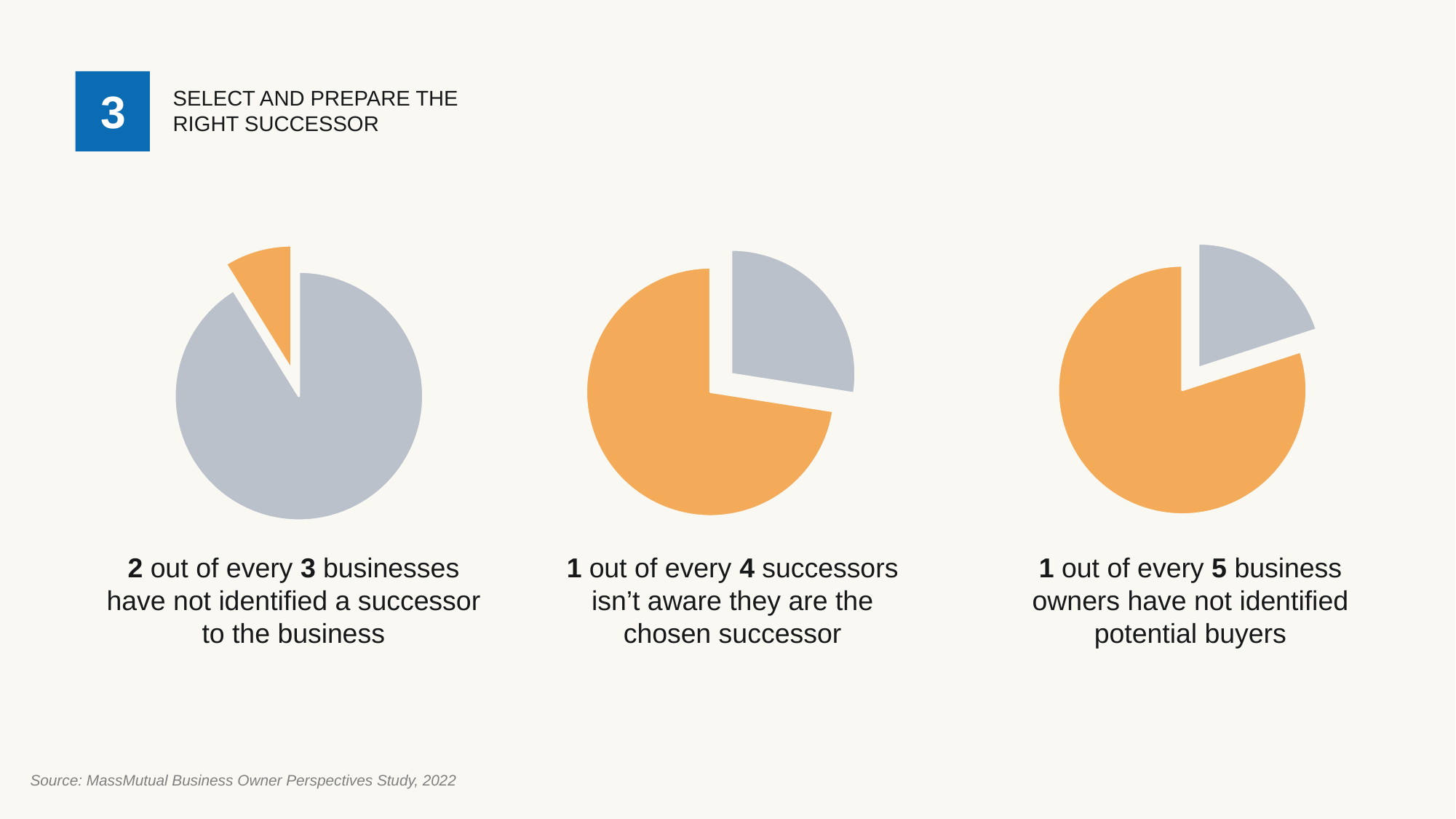
What kind of chart is the left-hand chart on the slide? pie chart In the right-hand pie chart, which slice is larger, the orange one or the grey one? orange In the right-hand pie chart, which slice is pulled out from the rest of the pie? the grey slice How many pie charts are shown on the slide? 3 According to the caption under the left-hand pie chart, how many out of every 3 businesses have not identified a successor to the business? 2 How many slices does the middle pie chart have? 2 In the left-hand pie chart, which slice is larger, the orange one or the grey one? grey According to the caption under the middle pie chart, how many out of every 4 successors aren't aware they are the chosen successor? 1 What source is cited at the bottom of the slide for the charts? MassMutual Business Owner Perspectives Study, 2022 In the middle pie chart, which slice is larger, the orange one or the grey one? orange According to the caption under the right-hand pie chart, how many out of every 5 business owners have not identified potential buyers? 1